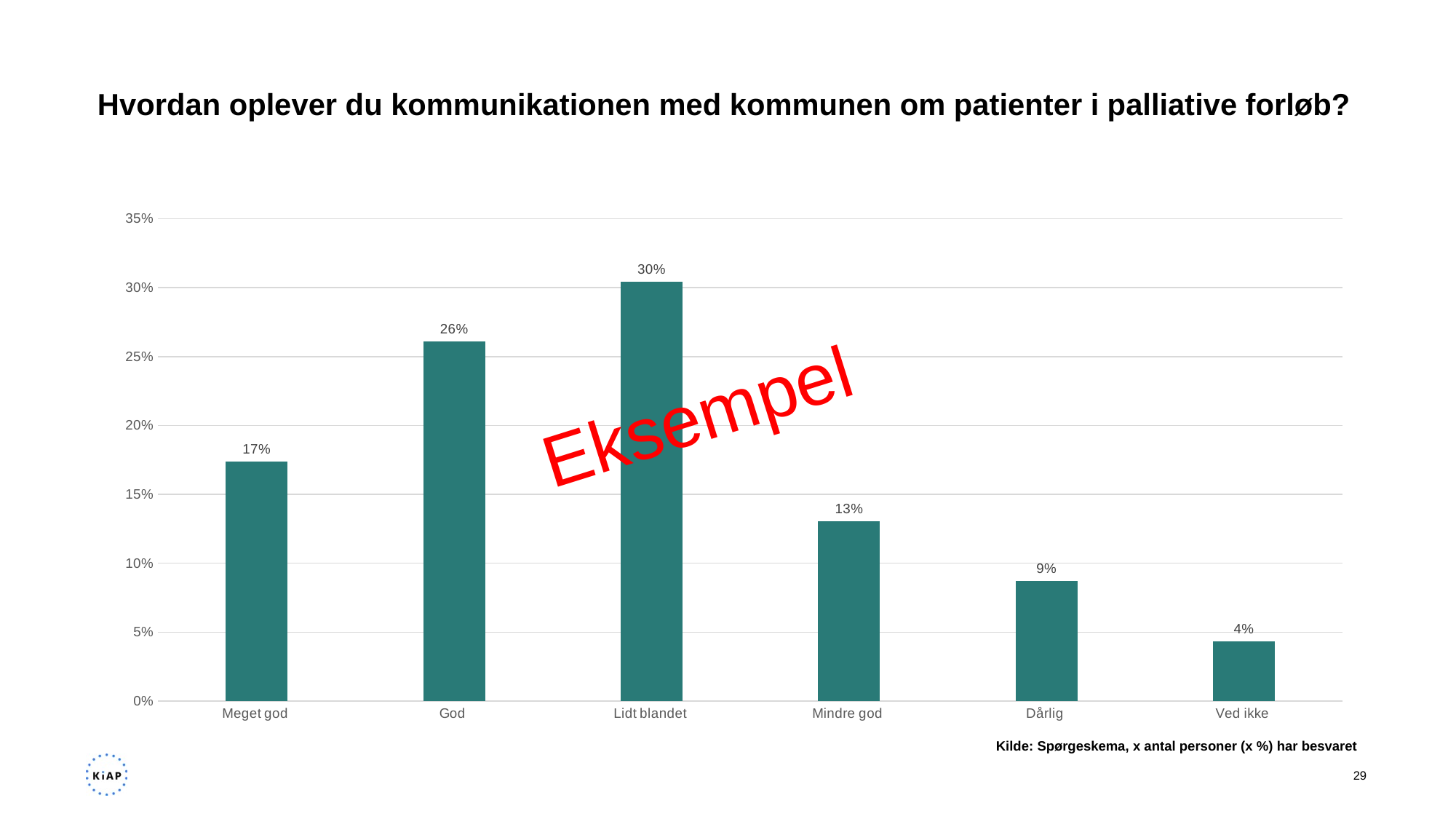
What is the title of the chart? Hvordan oplever du kommunikationen med kommunen om patienter i palliative forløb? What is the value for "Ved ikke"? 4% What is the difference between the values for "God" and "Mindre god"? 13% Which is larger, the value for "Dårlig" or the value for "Mindre god"? Mindre god Is the value for "God" greater or less than 25%? greater How many categories are shown on the x axis? 6 Which category has the highest value? Lidt blandet What is the value for "Lidt blandet"? 30% What is the difference between the values for "Lidt blandet" and "Ved ikke"? 26% What is the value for "Meget god"? 17% What kind of chart is shown on the slide? Bar chart Which category has the lowest value? Ved ikke